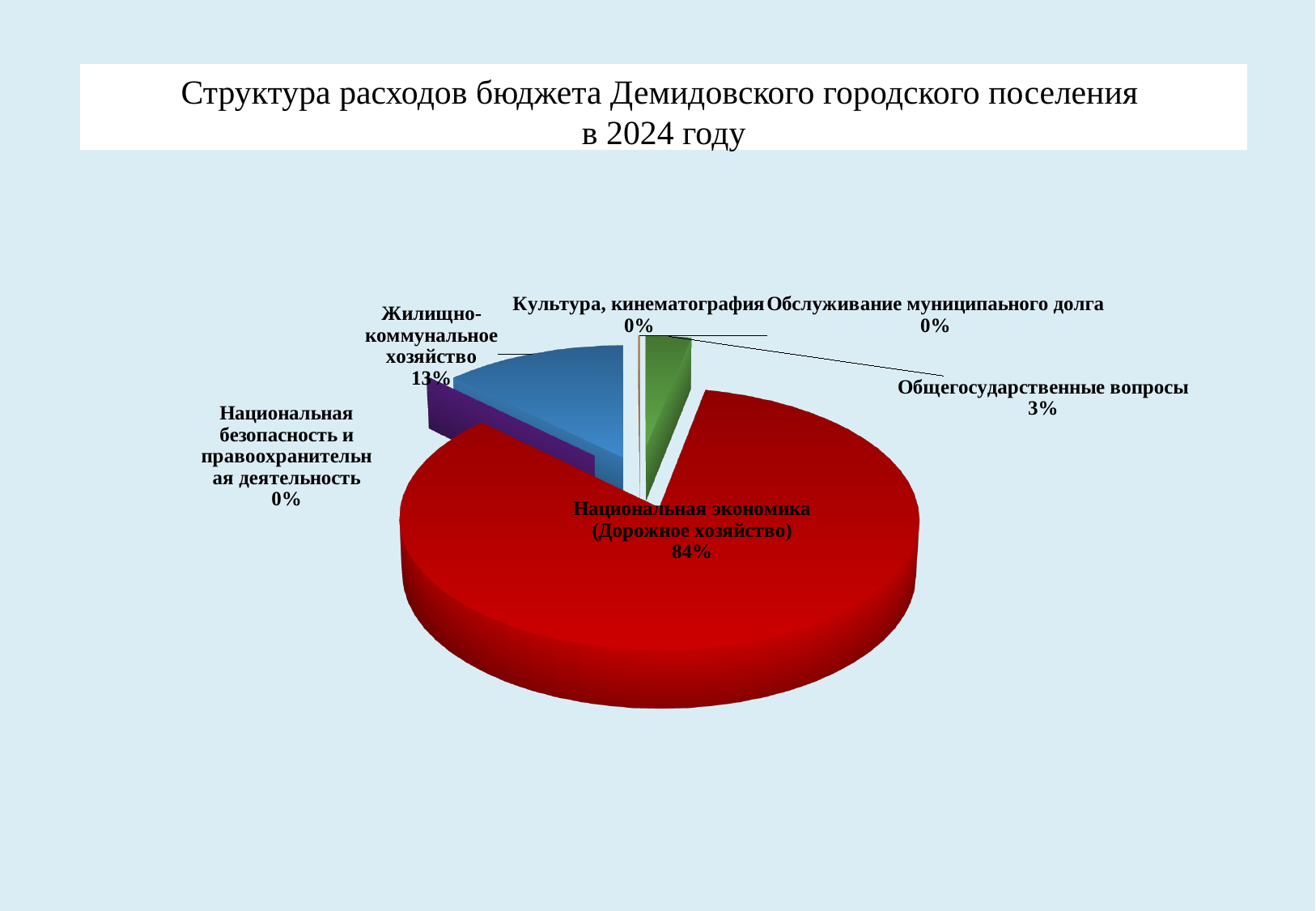
How many categories are labelled on the pie chart? 6 Which is larger: the share for Жилищно-коммунальное хозяйство or the share for Общегосударственные вопросы? Жилищно-коммунальное хозяйство What is the difference in percentage points between Национальная экономика (Дорожное хозяйство) and Жилищно-коммунальное хозяйство? 71 percentage points Which category has the largest share of the pie? Национальная экономика (Дорожное хозяйство) What kind of chart is shown on the slide? Pie chart What share of the budget expenditure goes to Жилищно-коммунальное хозяйство? 13% What is the title of the slide? Структура расходов бюджета Демидовского городского поселения в 2024 году What colour is the slice for Национальная экономика (Дорожное хозяйство)? Red What share is shown for Культура, кинематография? 0% How many categories are labelled with 0%? 3 What share of the budget expenditure goes to Национальная экономика (Дорожное хозяйство)? 84% What share of the budget expenditure goes to Общегосударственные вопросы? 3%